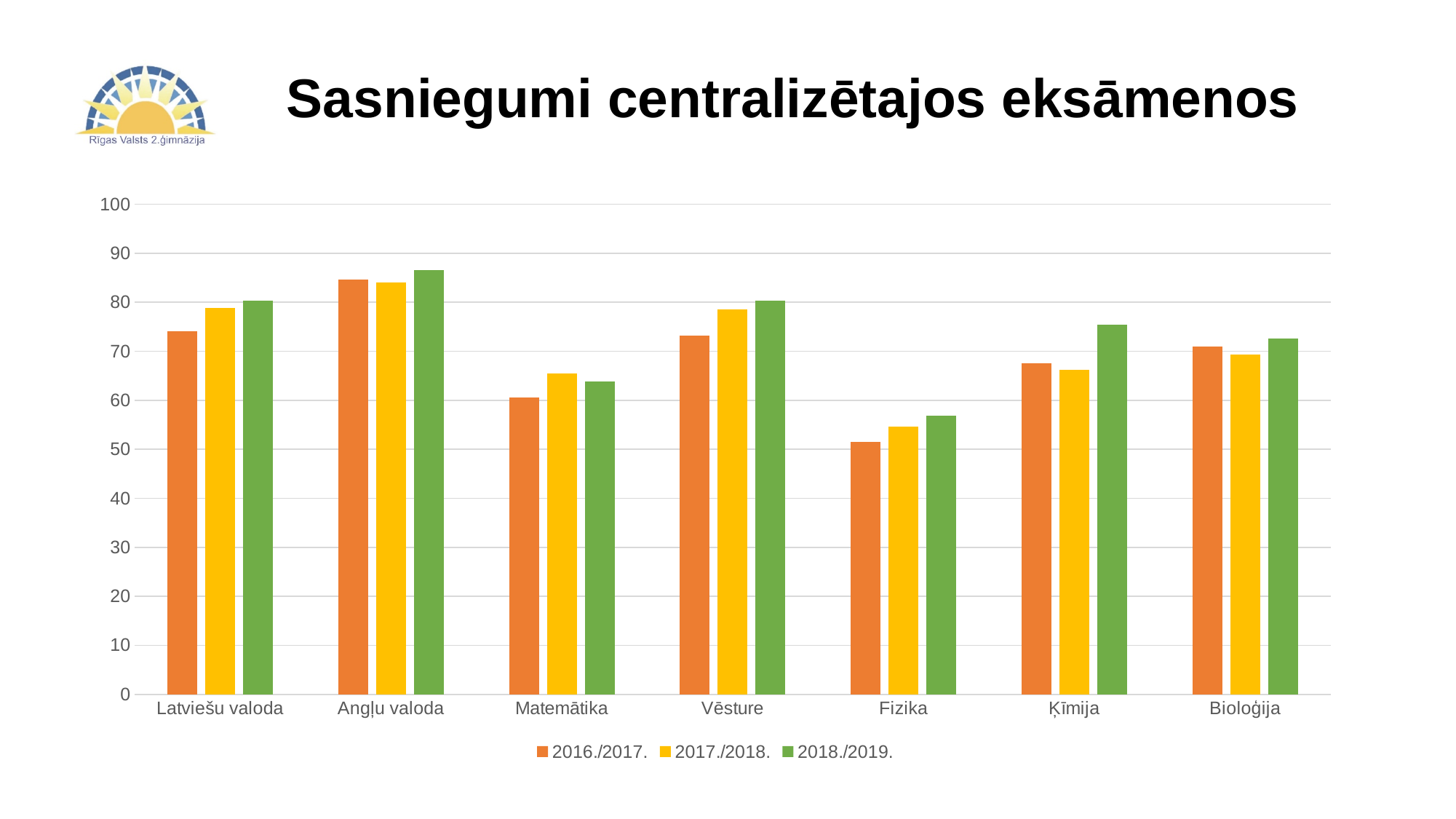
What kind of chart is shown on the slide? bar chart Which subject has the lowest value for the 2016./2017. series? Fizika How many series does the legend list? 3 Is the value for Fizika in 2016./2017. greater or less than 60? less Is the value for Angļu valoda in 2018./2019. greater or less than 80? greater How many subject categories are shown on the x axis? 7 Is the value for Ķīmija in 2018./2019. greater or less than 70? greater What is the title of the chart? Sasniegumi centralizētajos eksāmenos For Ķīmija, which series has the larger value: 2016./2017. or 2018./2019.? 2018./2019. Do the values for Fizika rise or fall from 2016./2017. to 2018./2019.? rise Which is larger for the 2018./2019. series: Matemātika or Fizika? Matemātika Which subject has the highest value for the 2018./2019. series? Angļu valoda